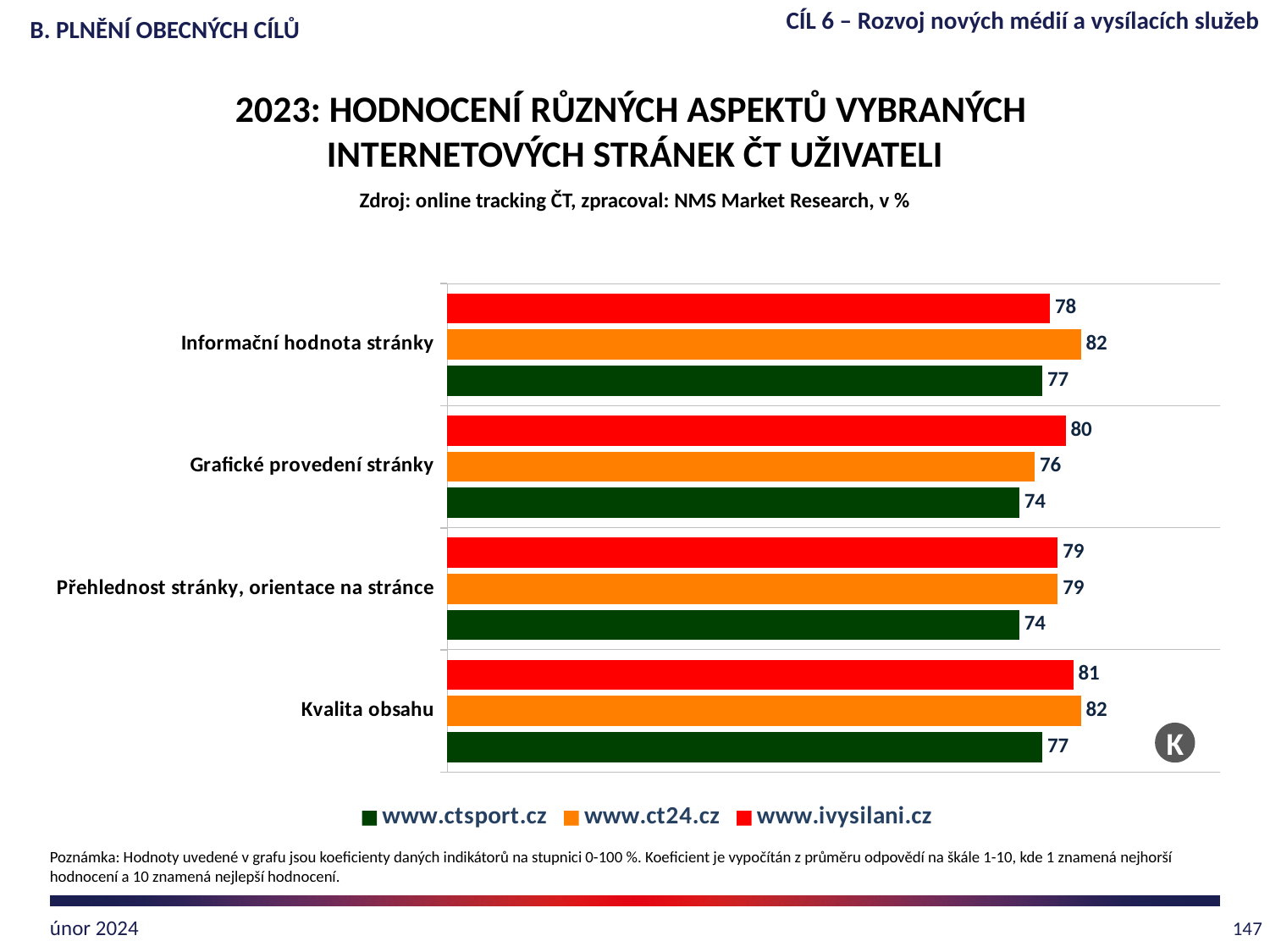
What is the difference between www.ct24.cz and www.ctsport.cz for Informační hodnota stránky? 5 What is the value for www.ctsport.cz for Grafické provedení stránky? 74 What is the value for www.ivysilani.cz for Kvalita obsahu? 81 What is the value for www.ivysilani.cz for Přehlednost stránky, orientace na stránce? 79 Which is larger for Grafické provedení stránky: www.ivysilani.cz or www.ct24.cz? www.ivysilani.cz Which website has the lowest value for Kvalita obsahu? www.ctsport.cz Which website has the highest value for Grafické provedení stránky? www.ivysilani.cz How many series does the legend list? 3 How many categories (aspects) are shown on the chart? 4 What kind of chart is shown on the slide? Bar chart Which colour represents www.ct24.cz in the chart? Orange What is the value for www.ct24.cz for Informační hodnota stránky? 82